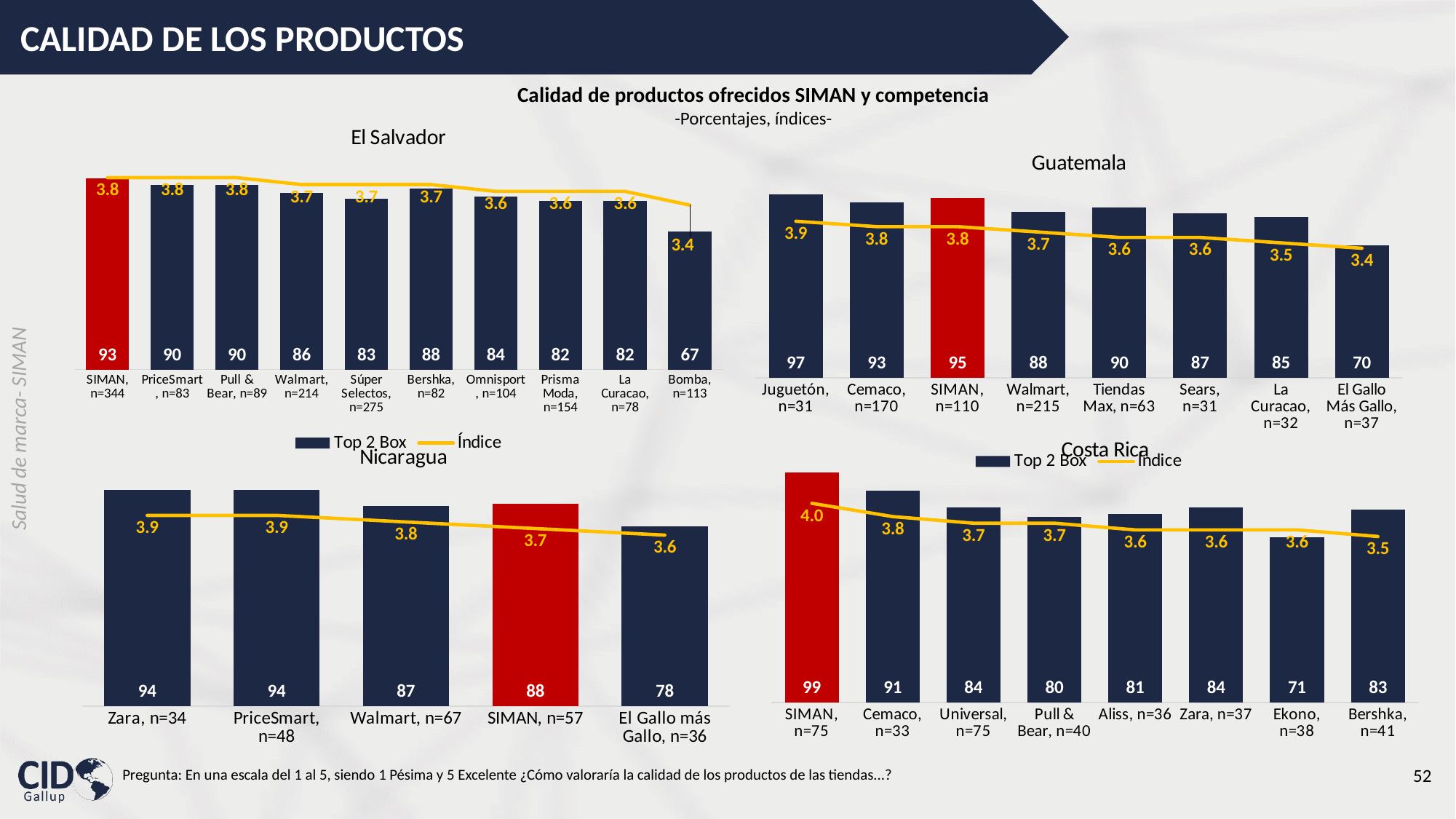
In the Costa Rica chart, what is the Top 2 Box value for Ekono? 71 What kind of chart is the Nicaragua chart? Bar chart with a line In the Guatemala chart, which store has the highest Top 2 Box value? Juguetón How many series does the legend list under the El Salvador chart? 2 In the Guatemala chart, what is the difference between the Top 2 Box values of SIMAN and El Gallo Más Gallo? 25 In the El Salvador chart, what is the Índice value for Bomba? 3.4 In the Nicaragua chart, what is the Índice value for SIMAN? 3.7 In the El Salvador chart, which store has the lowest Top 2 Box value? Bomba In the El Salvador chart, what is the Top 2 Box value for SIMAN? 93 In the Costa Rica chart, what is the Índice value for SIMAN? 4.0 In the Nicaragua chart, which is larger, the Top 2 Box value for Walmart or for SIMAN? SIMAN In the Guatemala chart, how many stores are shown? 8